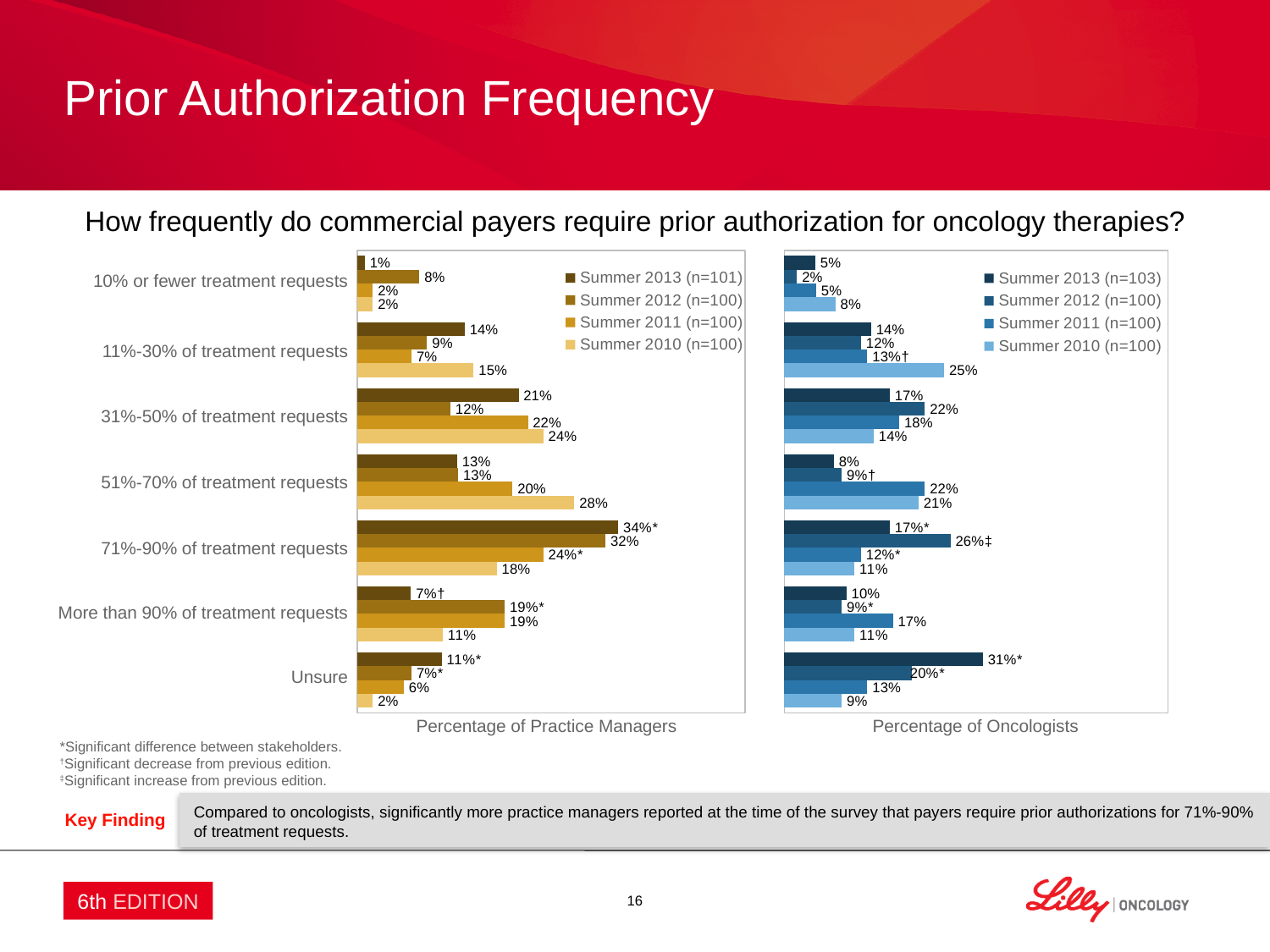
In the Percentage of Practice Managers chart, what is the Summer 2012 value for More than 90% of treatment requests? 19%* In the Percentage of Practice Managers chart, what is the Summer 2010 value for 51%-70% of treatment requests? 28% In the Percentage of Oncologists chart, which category has the highest Summer 2013 value? Unsure In the Percentage of Practice Managers chart, what percentage of Summer 2013 respondents said 71%-90% of treatment requests? 34%* For 71%-90% of treatment requests in Summer 2013, which is larger: the Practice Managers value or the Oncologists value? Practice Managers In the Percentage of Oncologists chart, what percentage of Summer 2010 respondents said 11%-30% of treatment requests? 25% In the Percentage of Oncologists chart, what is the difference between the Summer 2012 and Summer 2010 values for 71%-90% of treatment requests? 15 percentage points How many series does the legend of the Percentage of Oncologists chart list? 4 How many categories are shown on the y axis of the Percentage of Practice Managers chart? 7 What is the sample size for Summer 2013 in the Percentage of Oncologists chart legend? n=103 In the Percentage of Practice Managers chart, which category has the lowest Summer 2013 value? 10% or fewer treatment requests What type of chart is the Percentage of Oncologists chart? Bar chart